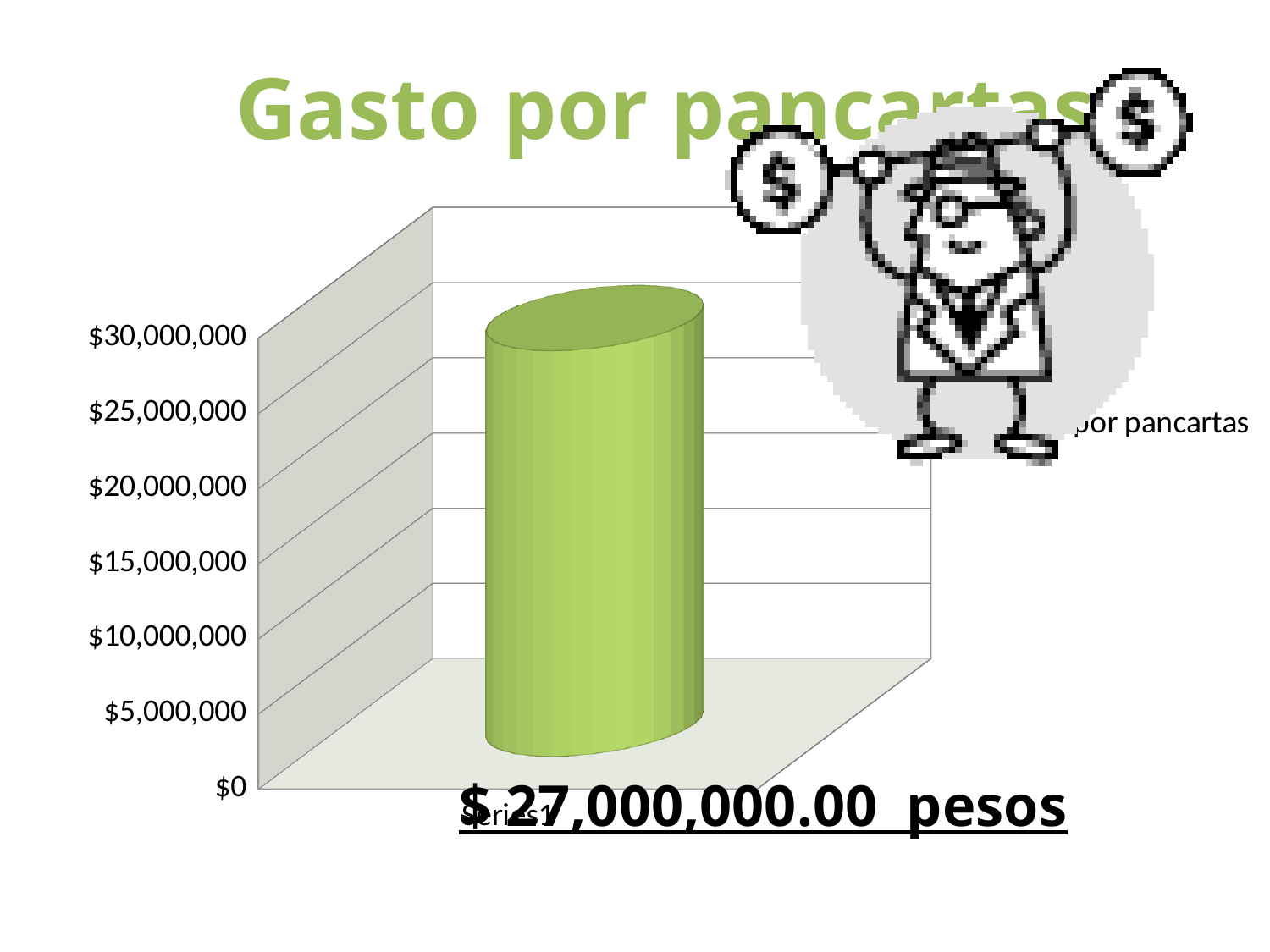
What value is printed on the slide for the gasto por pancartas bar? $ 27,000,000.00 pesos Is the value of the bar greater or less than $10,000,000? greater What is the highest tick label shown on the vertical axis? $30,000,000 What kind of chart is shown on the slide? bar chart Is the value of the bar greater or less than $15,000,000? greater Is the value of the bar greater or less than $20,000,000? greater What is the title of the chart? Gasto por pancartas How many bars are plotted in the chart? 1